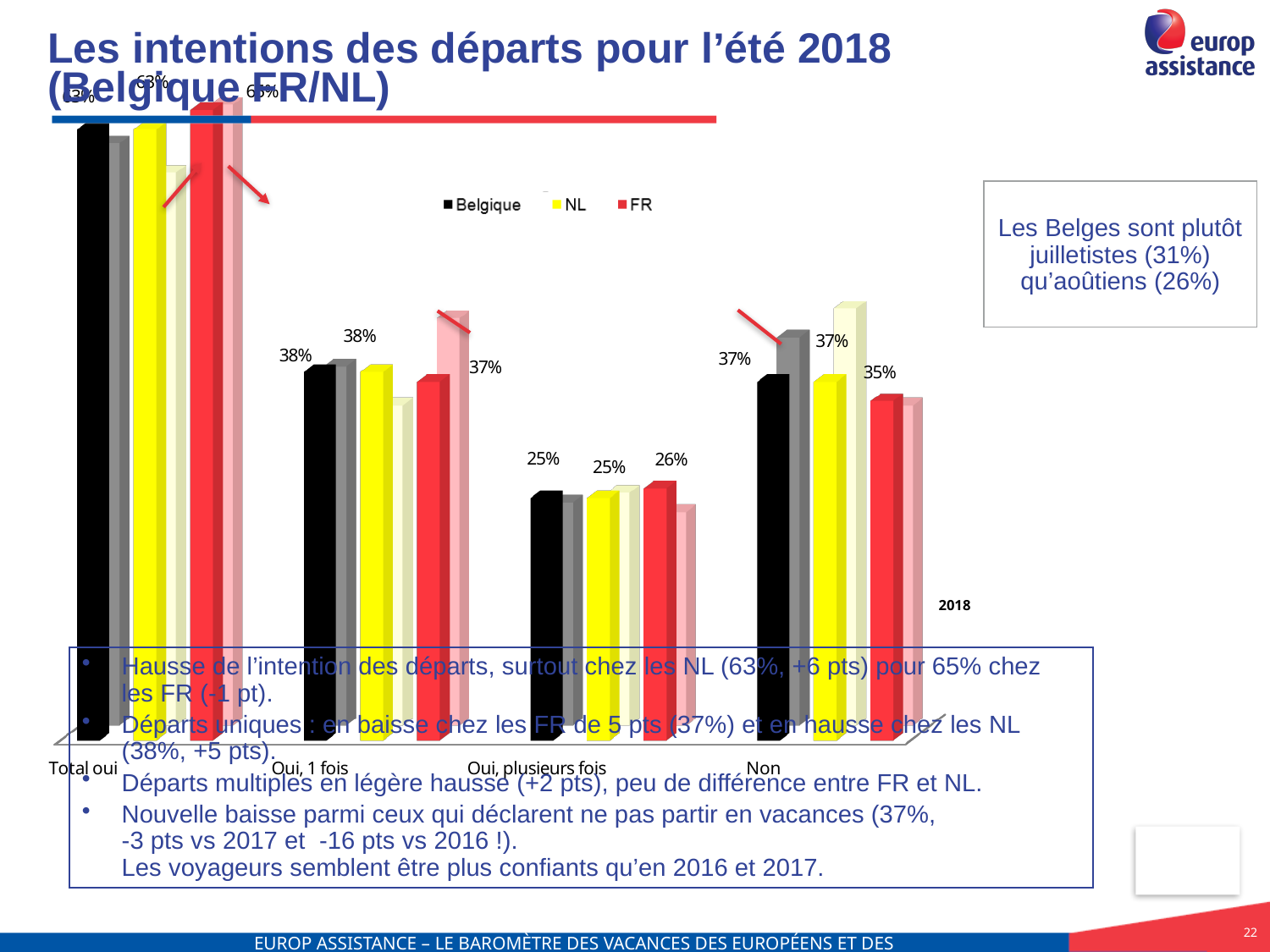
What is the value for Belgique in the 'Oui, plusieurs fois' category? 25% How many categories are shown along the x axis of the chart? 4 For the FR series, which category has the highest value? Total oui What is the difference between the Belgique value and the FR value in the 'Non' category? 2% What is the value for FR in the 'Non' category? 35% What is the value for FR in the 'Total oui' category? 65% What is the value for NL in the 'Oui, 1 fois' category? 38% What is the value for Belgique in the 'Non' category? 37% How many series does the chart legend list? 3 In the 'Total oui' category, which is larger: the NL value or the FR value? FR What kind of chart is shown on the slide? bar chart Which colour represents the NL series in the chart legend? yellow